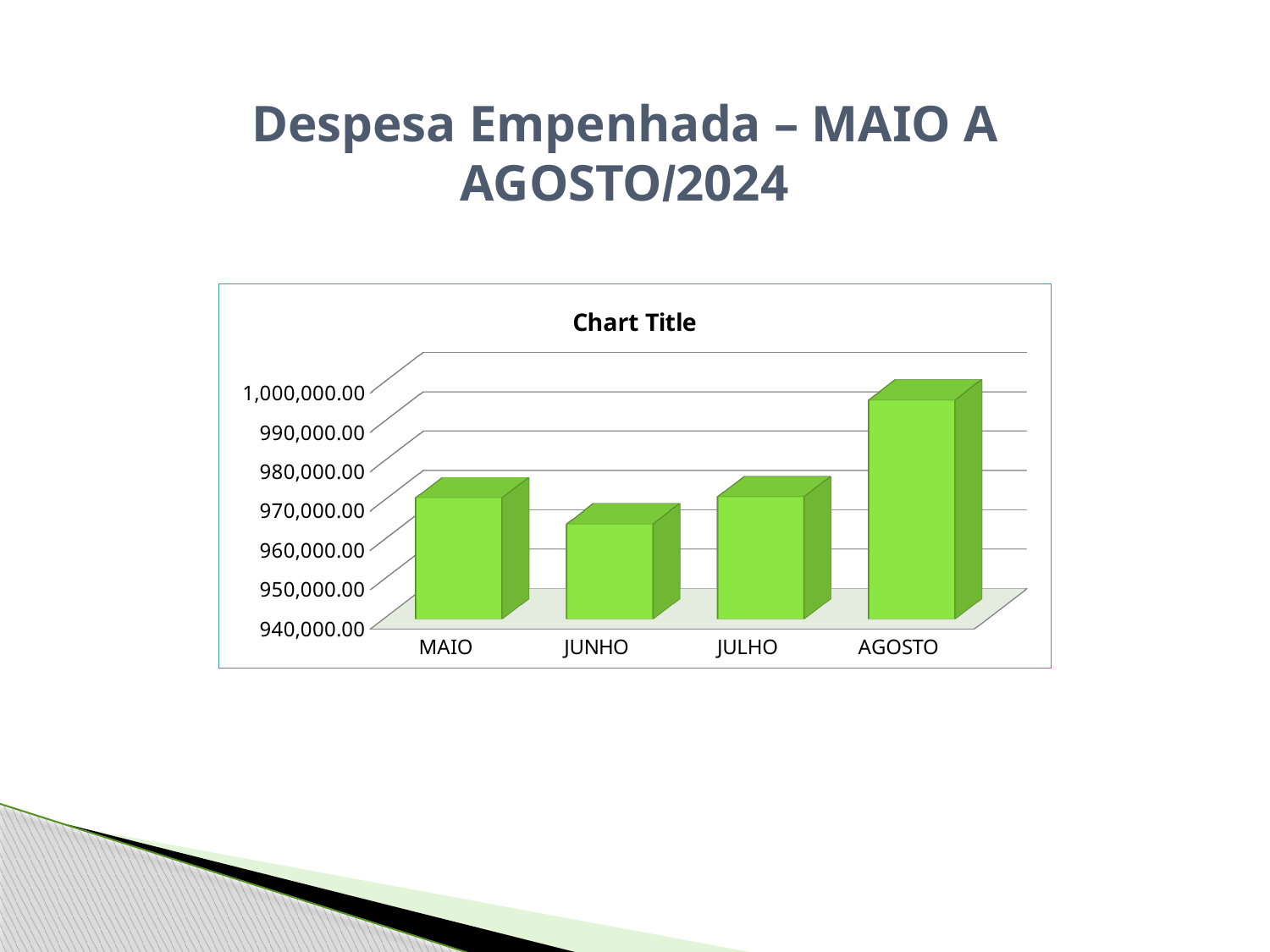
Is the value for MAIO greater or less than 960,000.00? greater How many categories are shown on the x axis of the chart? 4 Does the value rise or fall from JULHO to AGOSTO? rise Is the value for JULHO greater or less than 980,000.00? less Is the value for AGOSTO greater or less than 980,000.00? greater Which month has the highest bar in the chart? AGOSTO Which month has the lowest bar in the chart? JUNHO What kind of chart is shown on the slide? bar chart Which is larger, the value for AGOSTO or the value for JUNHO? AGOSTO What is the lowest value shown on the chart's vertical axis? 940,000.00 What is the title printed inside the chart area? Chart Title